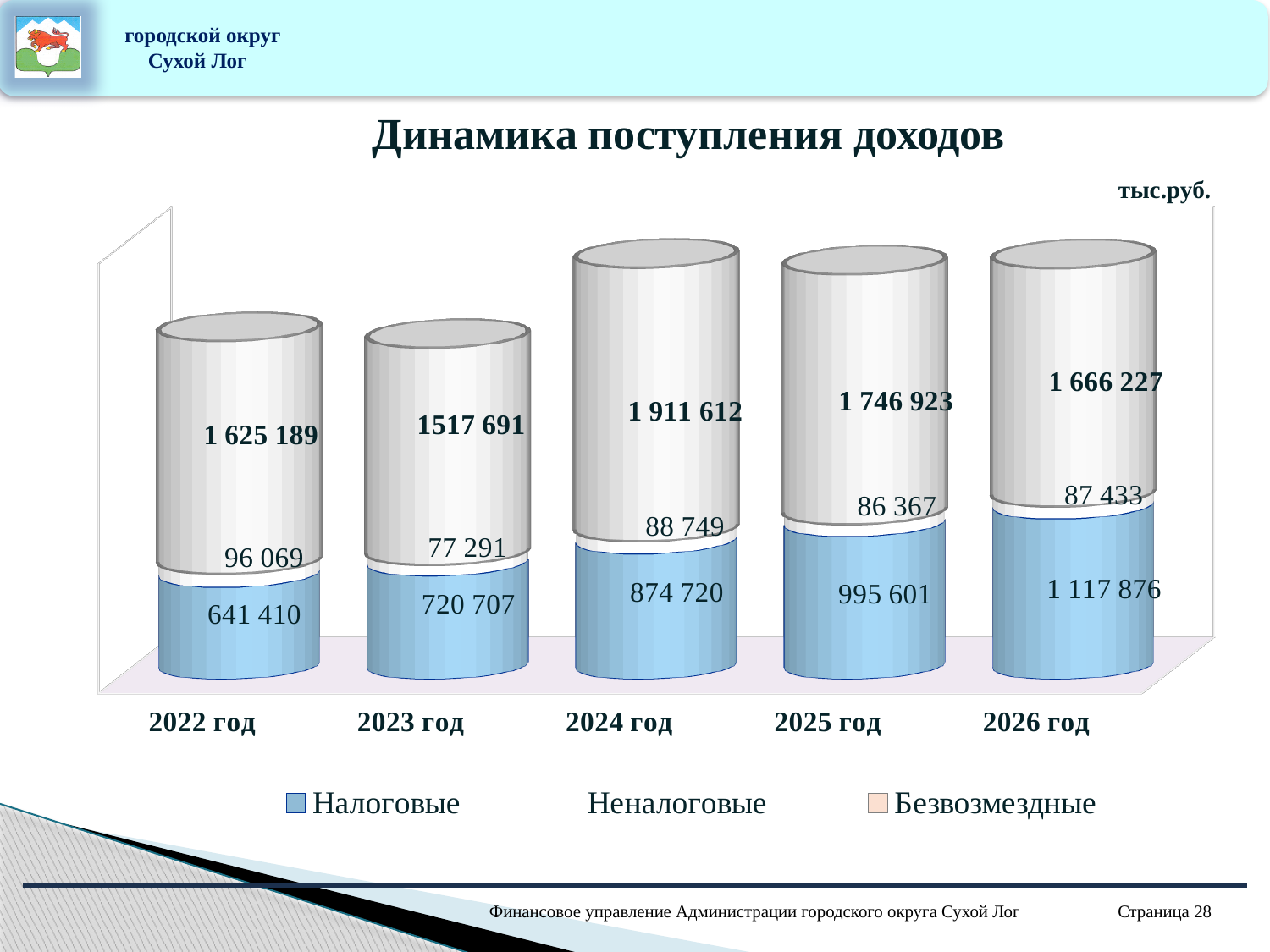
What is the total of the stacked bar for 2024 год? 2 875 081 Which is larger: the Безвозмездные value for 2024 год or for 2025 год? 2024 год What is the value for Налоговые in 2026 год? 1 117 876 What is the value for Налоговые in 2022 год? 641 410 What is the difference between the Налоговые values for 2026 год and 2022 год? 476 466 How many years are shown on the x axis? 5 What is the value for Безвозмездные in 2024 год? 1 911 612 In which year is the Неналоговые value the lowest? 2023 год How many series does the legend list? 3 What is the value for Неналоговые in 2025 год? 86 367 What kind of chart is shown on the slide? Stacked bar chart In which year is the Налоговые value the highest? 2026 год